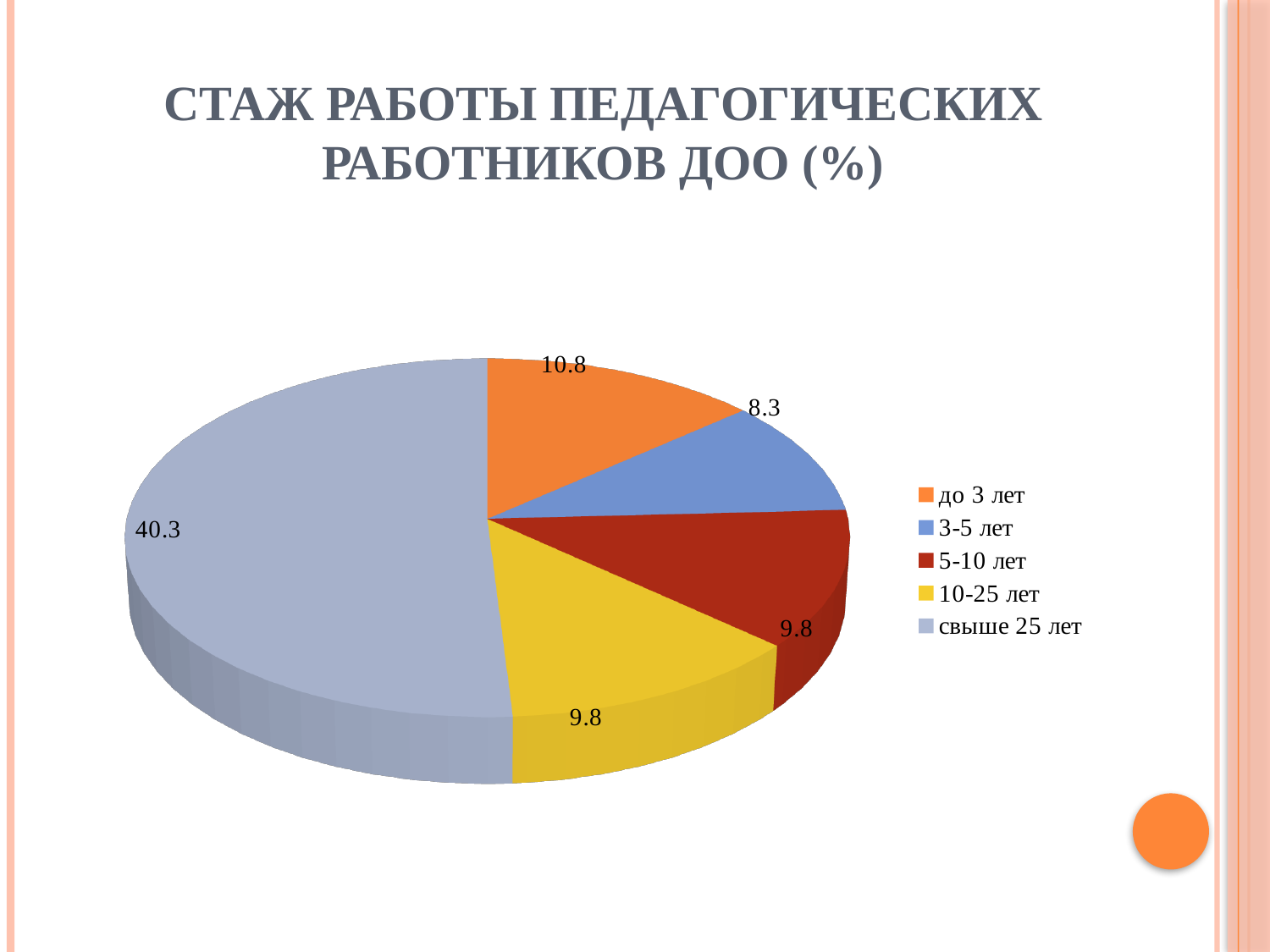
What is the value shown for the "до 3 лет" slice? 10.8 Which category has the largest slice of the pie? свыше 25 лет What is the value shown for the "свыше 25 лет" slice? 40.3 What is the value shown for the "5-10 лет" slice? 9.8 Which category has the smallest labelled value? 3-5 лет What kind of chart is shown on the slide? pie chart What is the difference between the values for "свыше 25 лет" and "до 3 лет"? 29.5 How many categories does the pie chart have? 5 Which is larger, the value for "до 3 лет" or the value for "3-5 лет"? до 3 лет What is the title of the chart on the slide? СТАЖ РАБОТЫ ПЕДАГОГИЧЕСКИХ РАБОТНИКОВ ДОО (%) What is the value shown for the "3-5 лет" slice? 8.3 Which colour represents the "10-25 лет" category in the legend? yellow